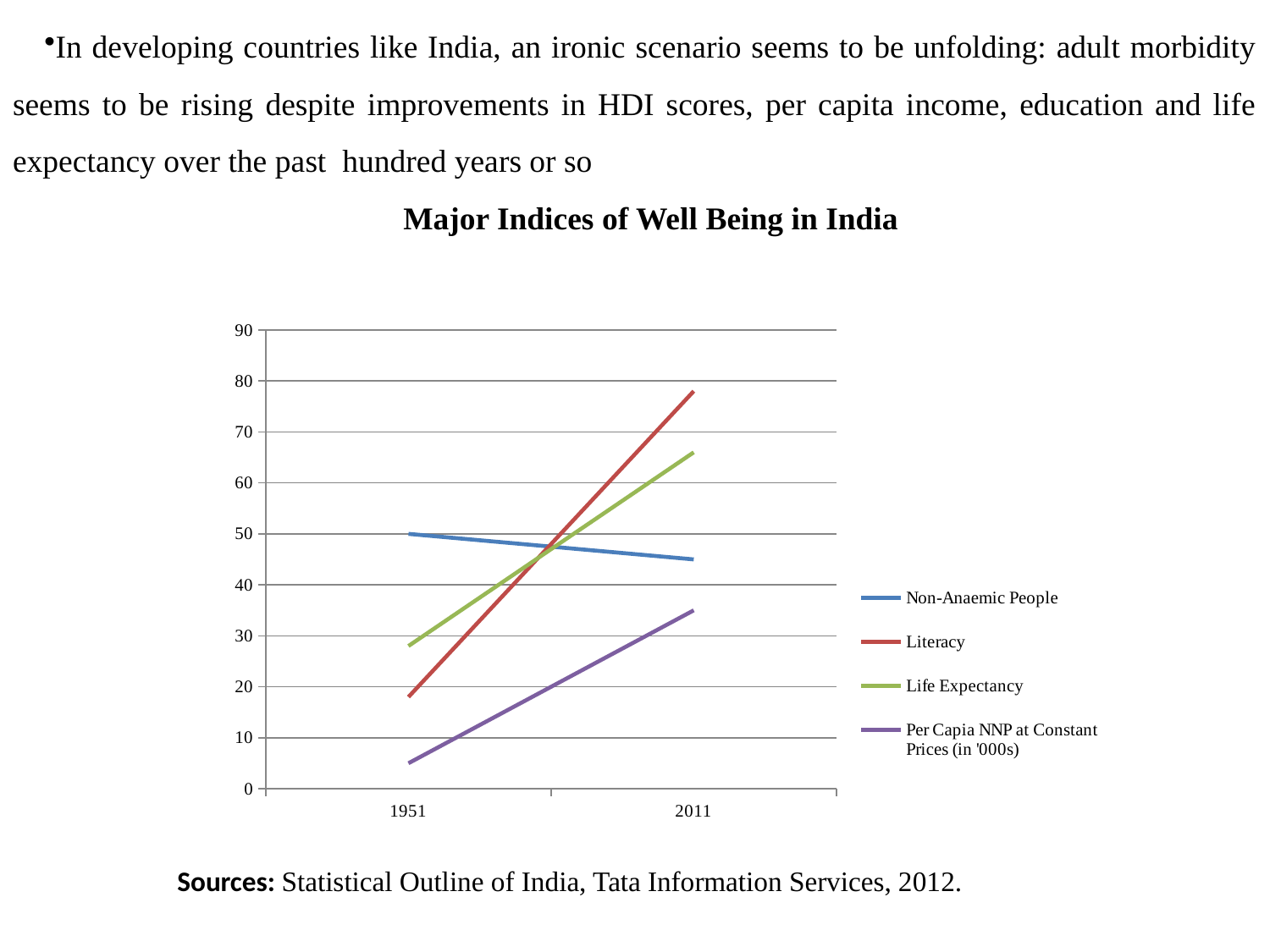
Is the value for Literacy in 2011 greater or less than 70? greater Which series has the highest value in 2011? Literacy What colour is the Literacy line? red How many years are shown on the x axis? 2 Which series has the lowest value in 1951? Per Capia NNP at Constant Prices (in '000s) Is the value for Life Expectancy in 1951 greater or less than 30? less How many series does the legend list? 4 What kind of chart is shown on the slide? line chart Does the Non-Anaemic People line rise or fall from 1951 to 2011? falls What is the title of the chart? Major Indices of Well Being in India In 2011, which is larger: Life Expectancy or Non-Anaemic People? Life Expectancy Does the Literacy line rise or fall from 1951 to 2011? rises